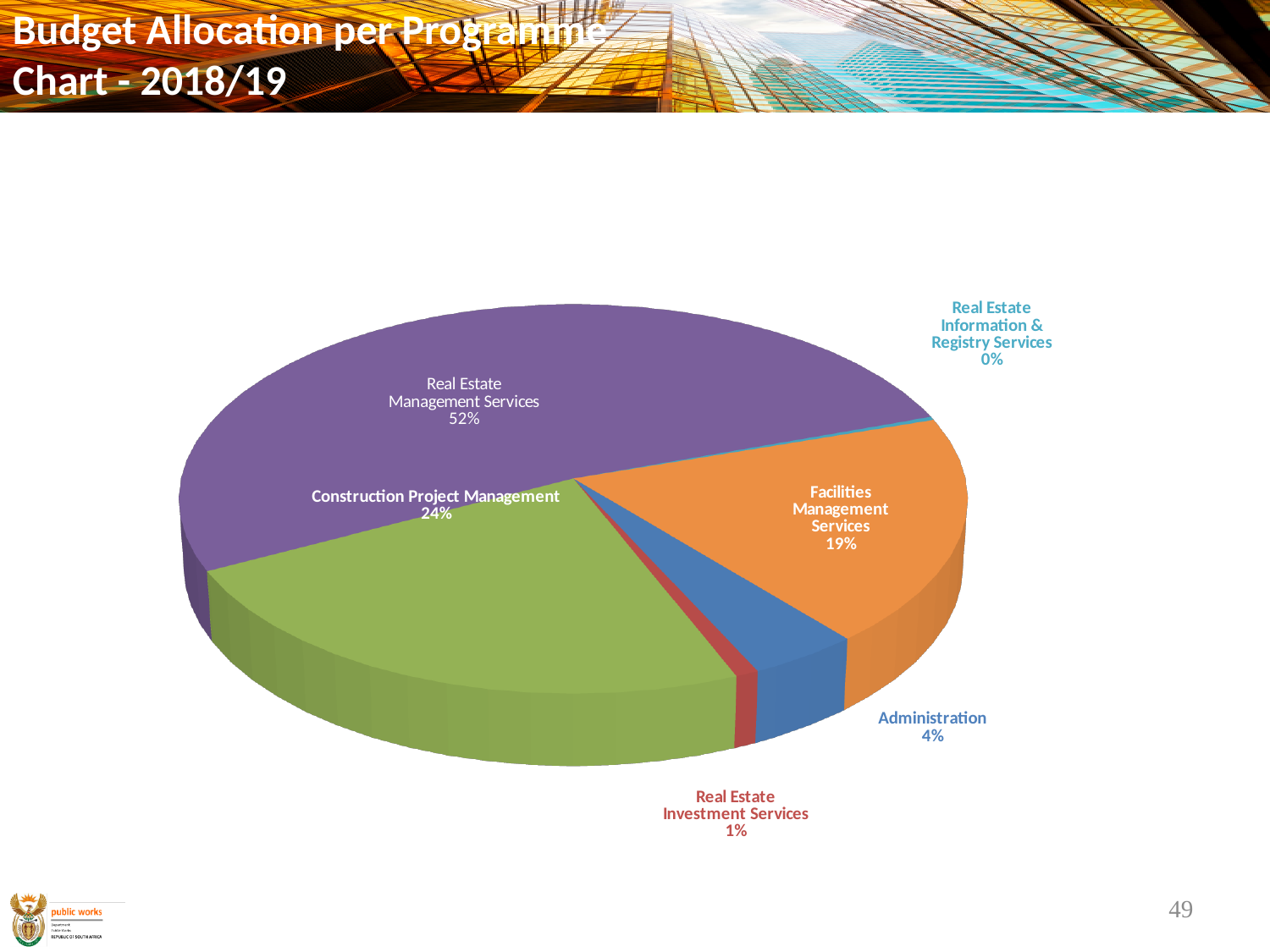
What share of the budget is allocated to Administration? 4% What share of the budget is allocated to Real Estate Information & Registry Services? 0% What is the difference in percentage points between Construction Project Management and Facilities Management Services? 5 percentage points Which receives a larger share of the budget, Administration or Facilities Management Services? Facilities Management Services What share of the budget is allocated to Construction Project Management? 24% Which programme receives the largest share of the budget? Real Estate Management Services How many programmes are shown in the pie chart? 6 Which programme receives the smallest share of the budget? Real Estate Information & Registry Services What kind of chart is shown on the slide? Pie chart